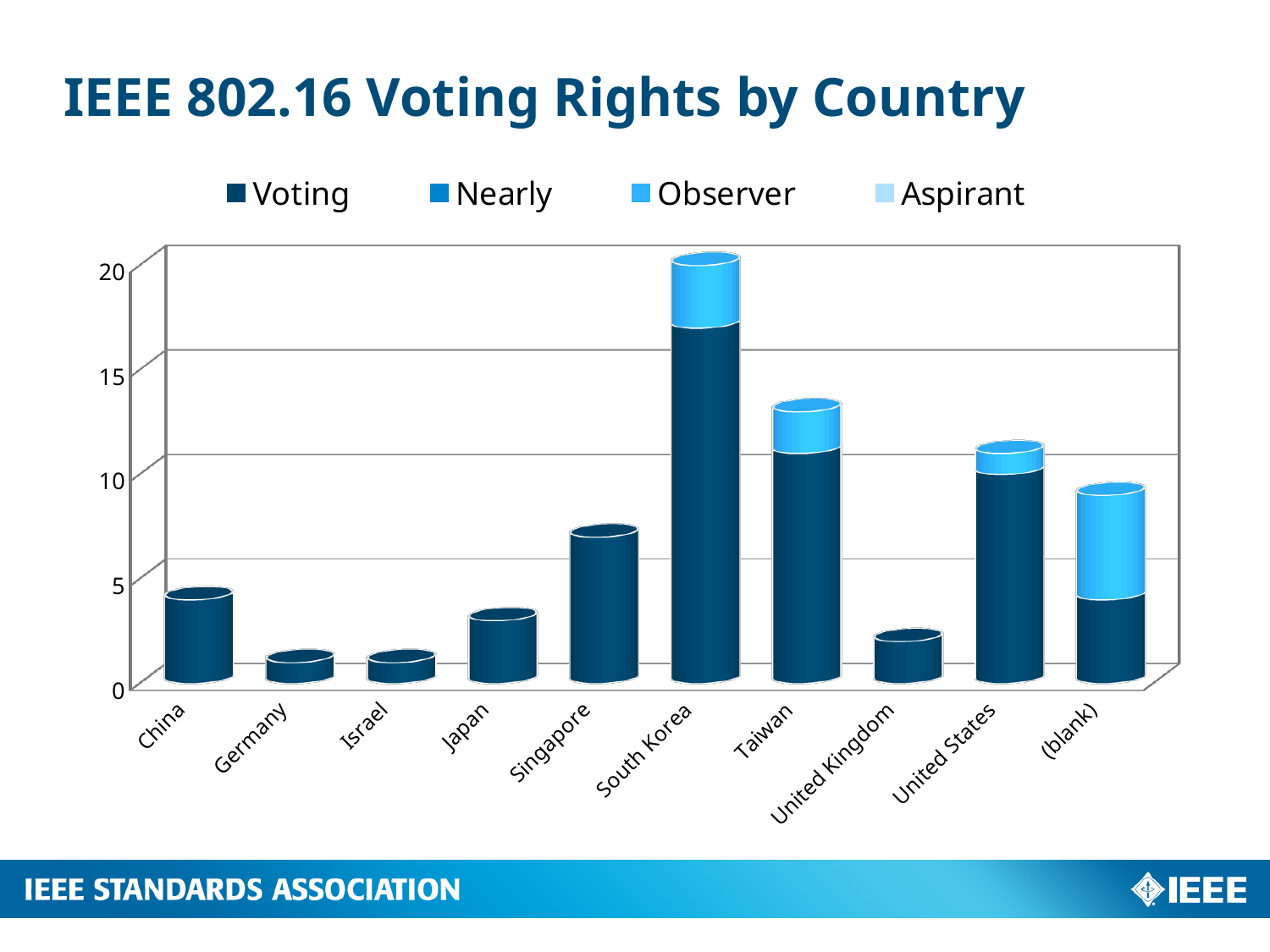
How many countries (categories) are shown on the x axis? 10 Which bar is taller, Singapore or Japan? Singapore Is the total for (blank) greater or less than 5? greater Which country has the tallest bar? South Korea How many series does the legend list? 4 What kind of chart is shown on the slide? Bar chart Is the total for South Korea greater or less than 15? greater Is the total for Singapore greater or less than 10? less What is the title of the chart? IEEE 802.16 Voting Rights by Country Which series is listed first in the legend? Voting